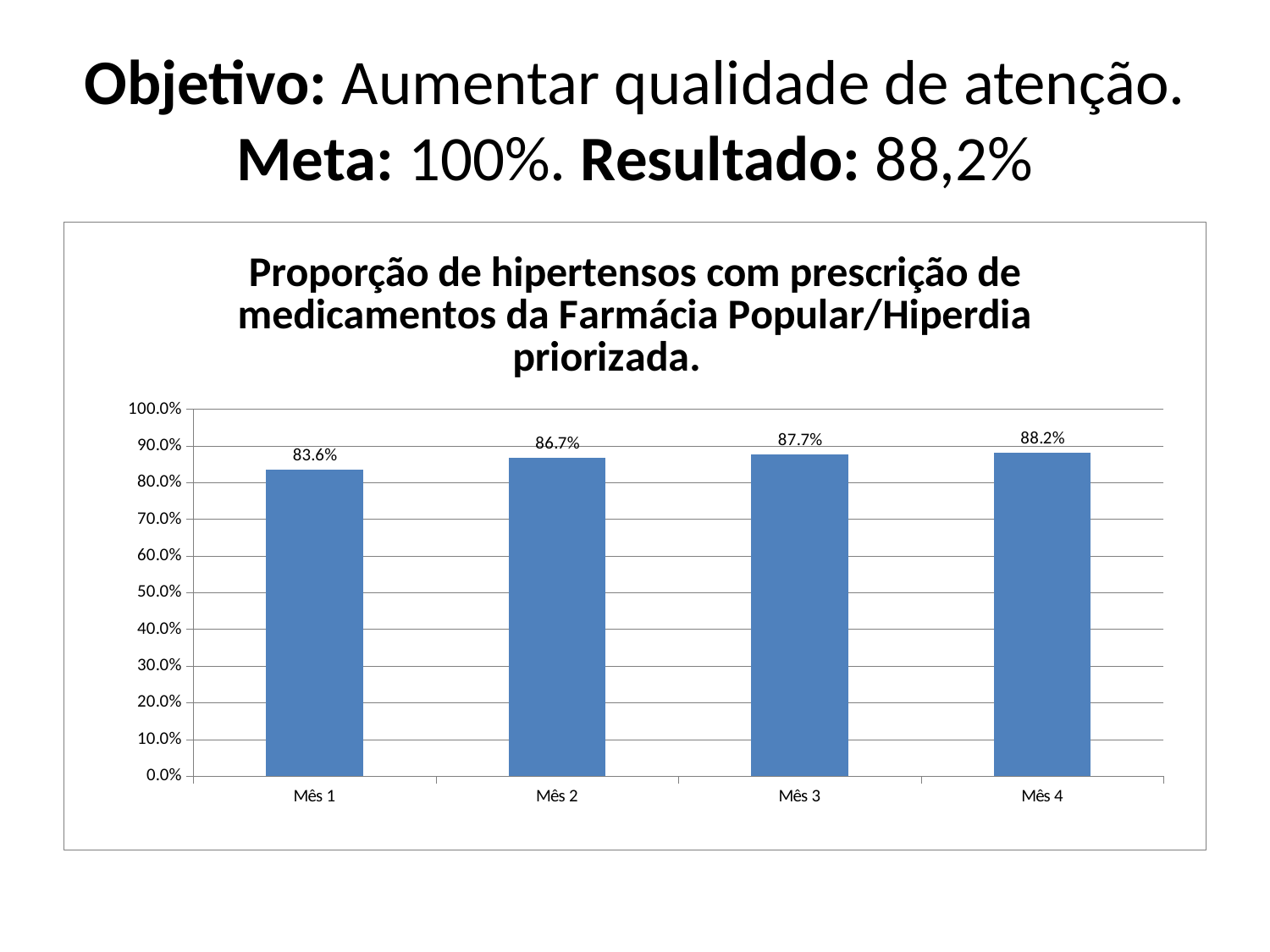
Is the value for Mês 3 greater or less than 90.0%? less Which month has the highest value? Mês 4 What is the value for Mês 1? 83.6% What is the difference between the values for Mês 4 and Mês 1? 4.6% Do the values rise or fall from Mês 1 to Mês 4? rise Which month has the lowest value? Mês 1 What is the value for Mês 4? 88.2% Which is larger, the value for Mês 2 or the value for Mês 1? Mês 2 What kind of chart is shown? bar chart How many months are shown on the x axis? 4 What is the value for Mês 3? 87.7% What is the value for Mês 2? 86.7%